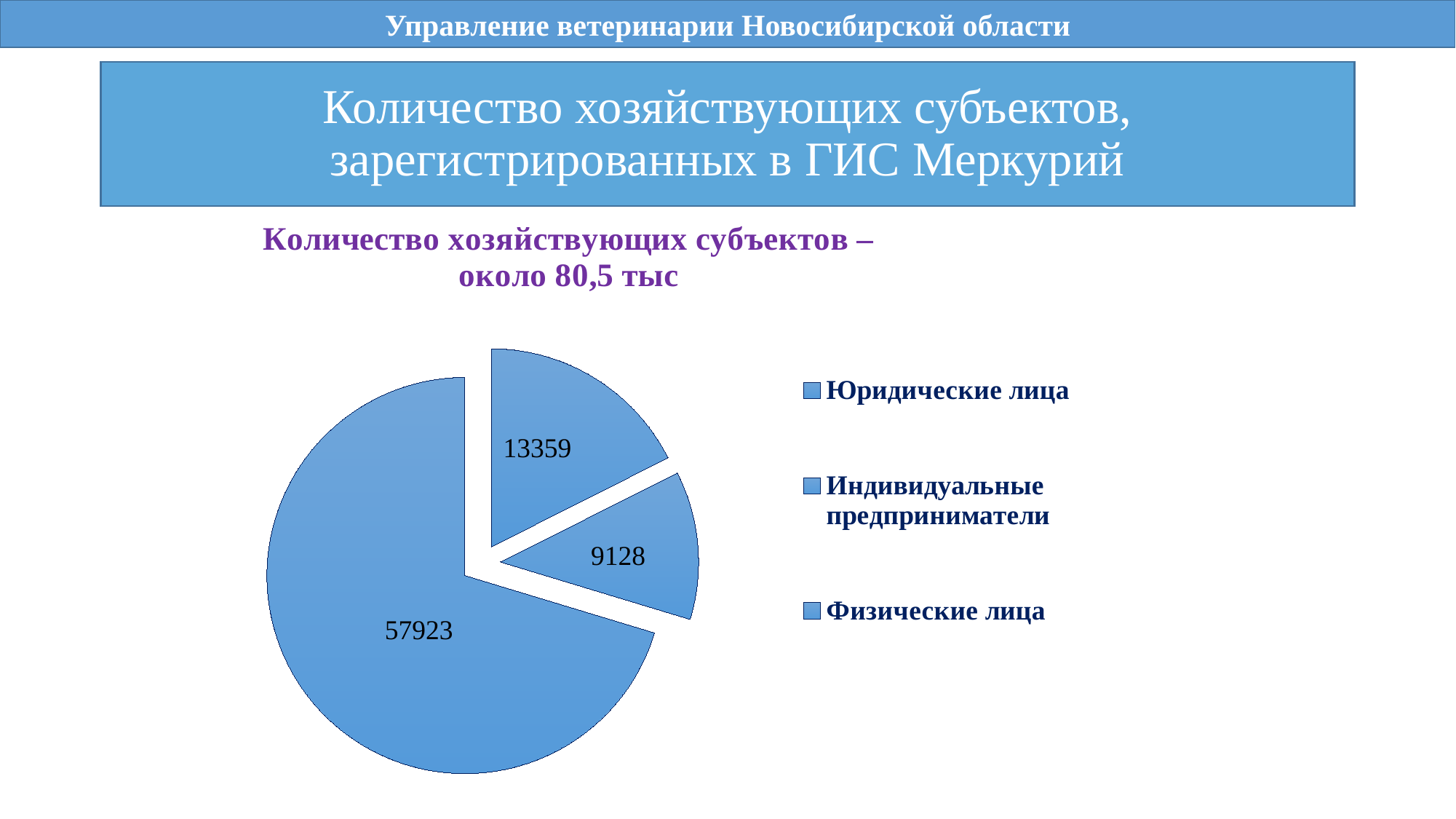
Which is larger: the slice labelled 13359 or the slice labelled 9128? 13359 How many entries does the legend of the pie chart list? 3 What is the value shown for Индивидуальные предприниматели in the pie chart? 9128 What is the value of the largest slice in the pie chart? 57923 What is the value of the smallest slice in the pie chart? 9128 What is the value shown for Юридические лица in the pie chart? 13359 What is the total of all three slices in the pie chart? 80410 What is the value shown for Физические лица in the pie chart? 57923 What is the first entry listed in the legend of the pie chart? Юридические лица How many slices does the pie chart have? 3 What is the difference between the slice labelled 13359 and the slice labelled 9128? 4231 What kind of chart is shown on the slide? pie chart